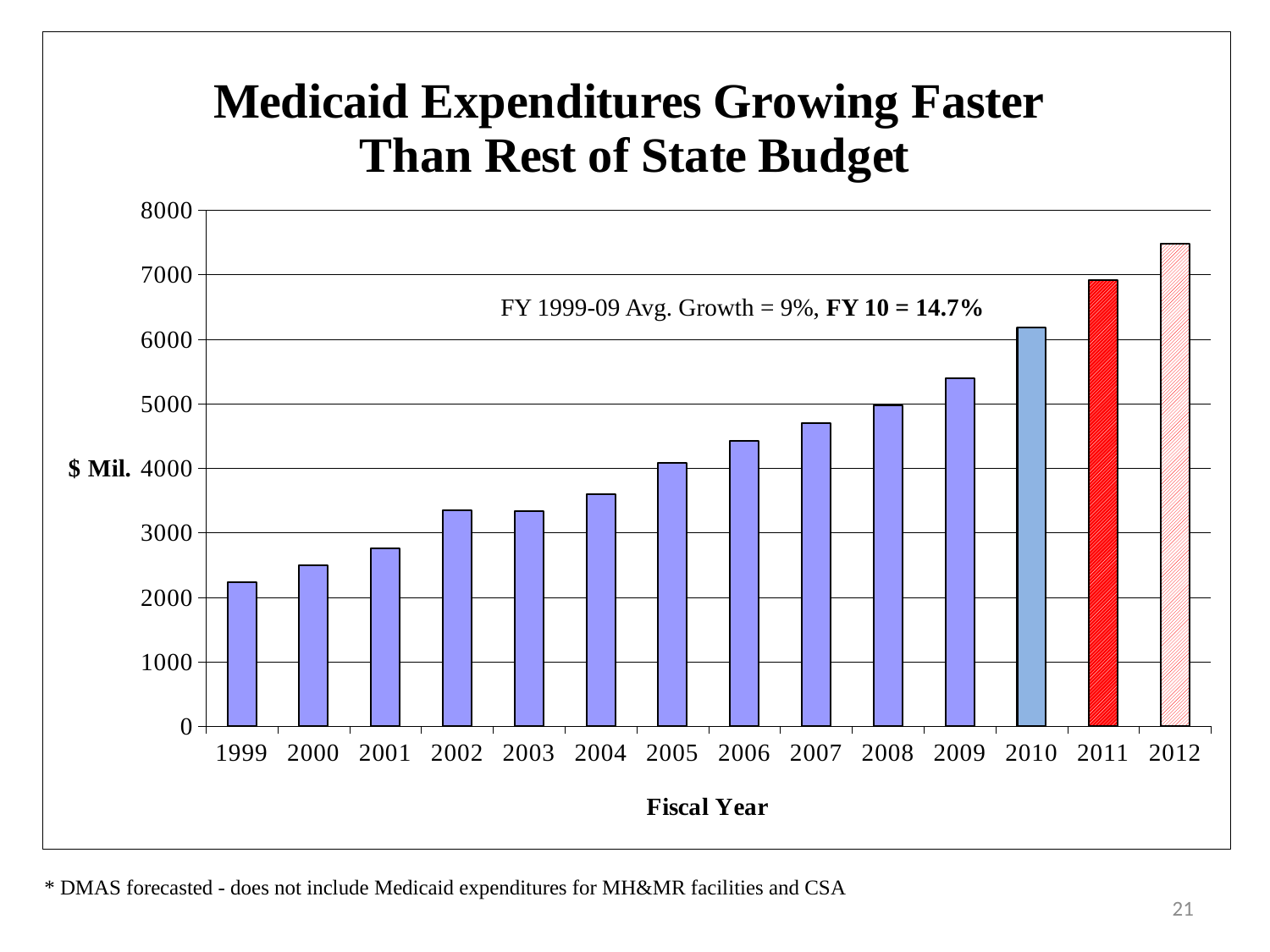
How many fiscal years are plotted on the x axis? 14 What is the label on the y axis? $ Mil. Is the value for 2010 greater or less than 6000? greater Is the value for 2009 greater or less than 6000? less Which fiscal year has the lowest Medicaid expenditure bar? 1999 Is the value for 1999 greater or less than 2000? greater According to the annotation on the chart, what was the FY 10 growth rate? 14.7% Do Medicaid expenditures generally rise or fall from 1999 to 2012? rise Which is larger, the value for 2011 or the value for 2010? 2011 What kind of chart is shown on the slide? bar chart Which fiscal year has the highest Medicaid expenditure bar? 2012